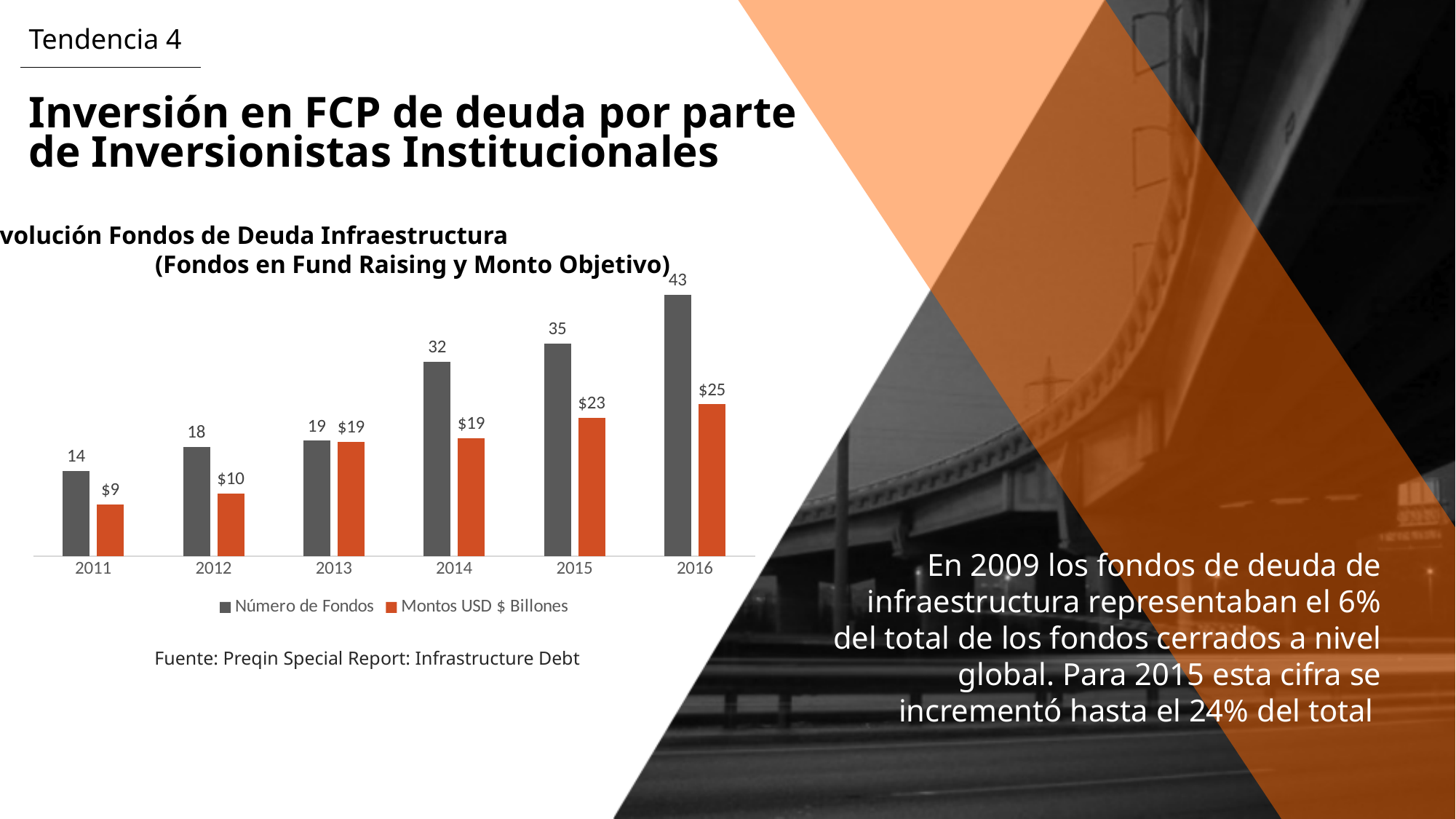
What is the difference in Número de Fondos between 2016 and 2011? 29 Which is larger, Número de Fondos in 2013 or in 2012? 2013 What is the value of Montos USD $ Billones for 2015? $23 What is the value of Número de Fondos for 2014? 32 How many years are shown on the x axis? 6 What kind of chart is shown on the slide? Bar chart What is the difference in Montos USD $ Billones between 2016 and 2015? $2 Which year has the highest Número de Fondos? 2016 Which year has the lowest Montos USD $ Billones? 2011 Does Número de Fondos rise or fall from 2011 to 2016? Rise How many series does the legend list? 2 What is the value of Montos USD $ Billones for 2011? $9